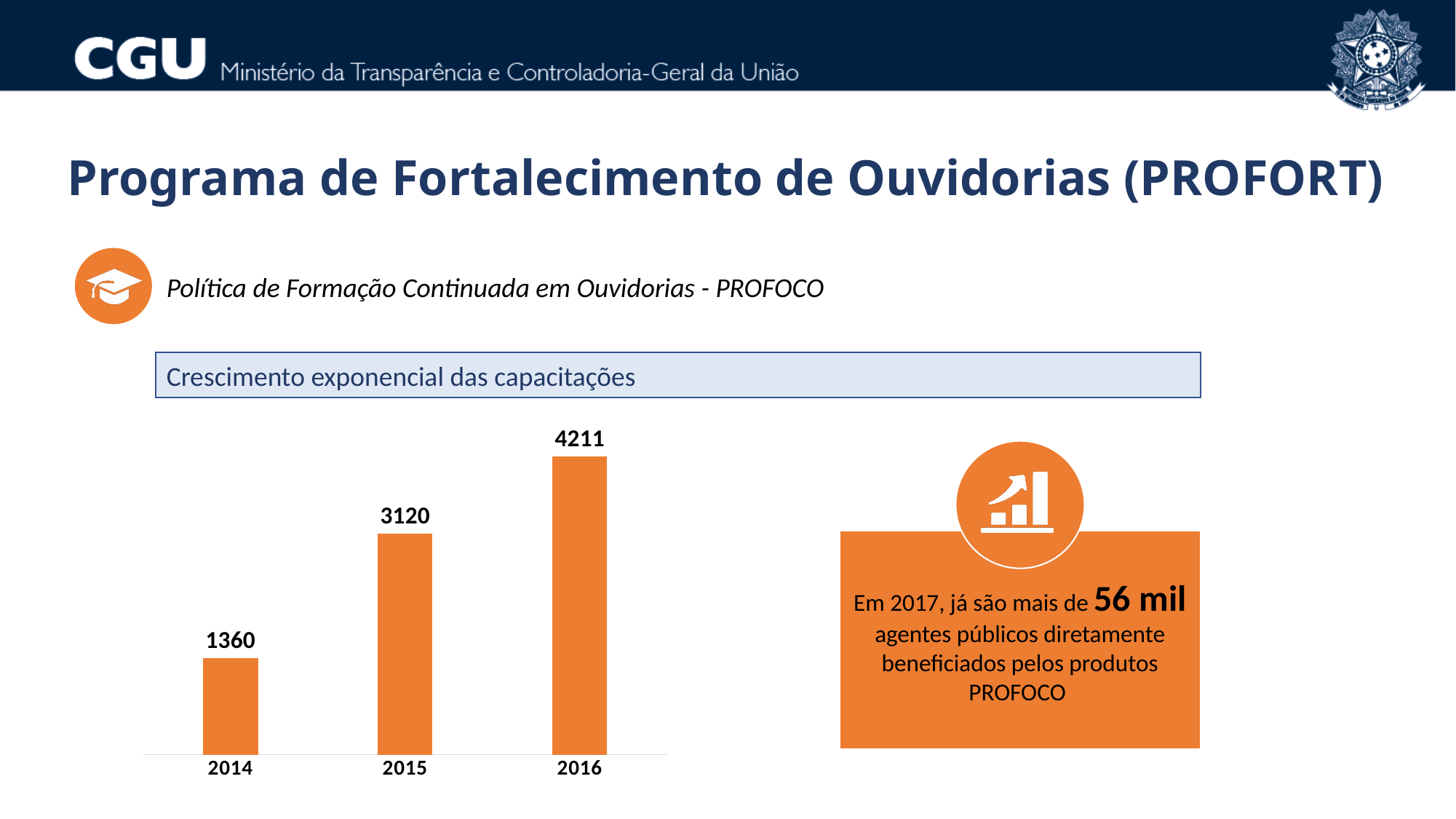
What colour are the bars in the chart? orange What is the difference between the values for 2016 and 2015? 1091 What is the value shown for 2016? 4211 What kind of chart is shown on the slide? bar chart How many years are shown on the chart? 3 What is the value shown for 2014? 1360 What is the value shown for 2015? 3120 Which year has the highest value? 2016 What is the difference between the values for 2015 and 2014? 1760 Do the values rise or fall from 2014 to 2016? rise Which is larger, the value for 2015 or the value for 2014? 2015 Which year has the lowest value? 2014